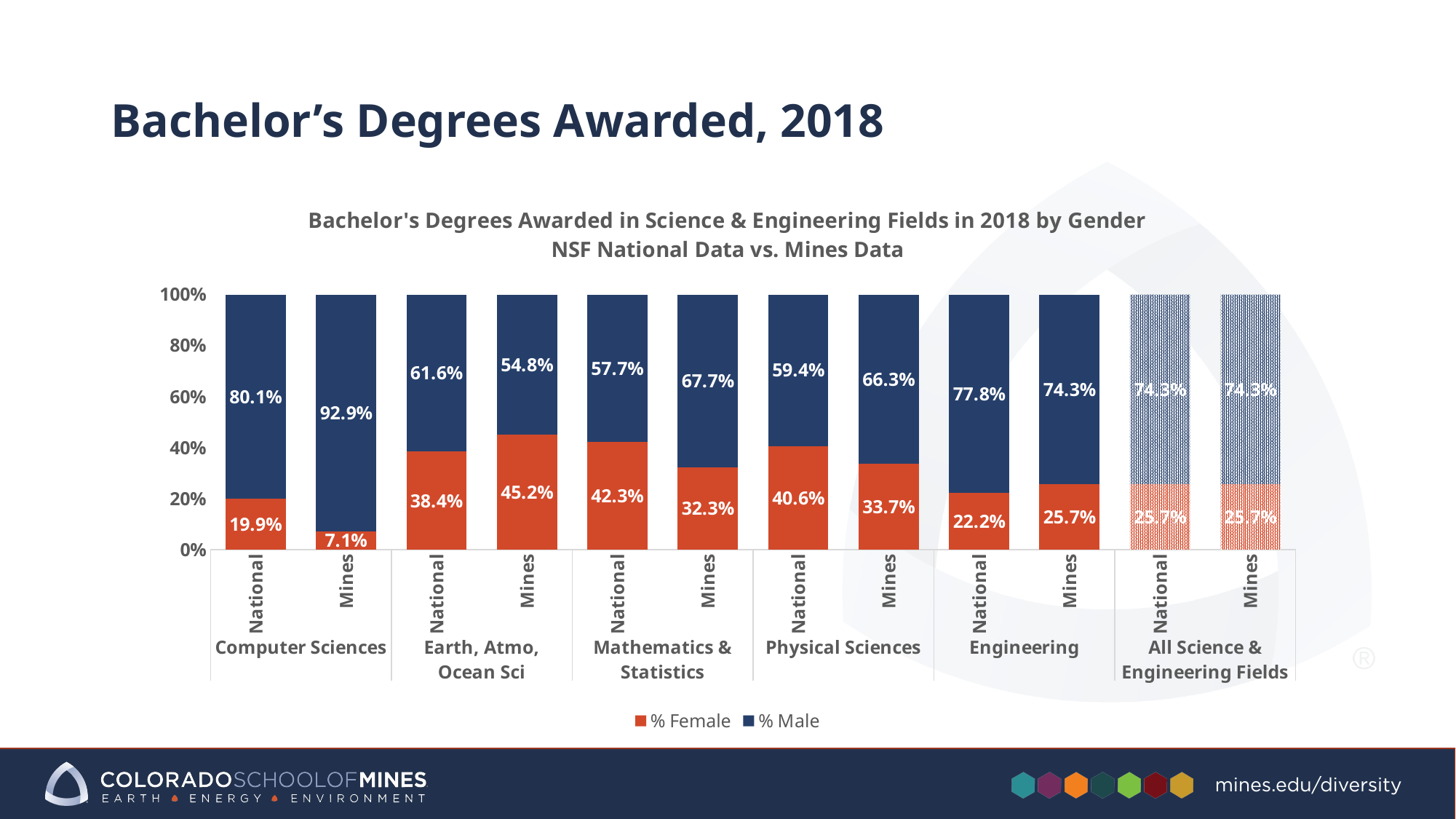
What is the % Male value for the National bar in Earth, Atmo, Ocean Sci? 61.6% What kind of chart is shown on the slide? Stacked bar chart How many series does the legend list? 2 Which bar has the highest % Female value? Mines, Earth, Atmo, Ocean Sci Which bar has the lowest % Female value? Mines, Computer Sciences How many bars are plotted in the chart? 12 What is the % Female value for the Mines bar in Computer Sciences? 7.1% What is the total of the stacked bar for National in Computer Sciences? 100% Which is larger: the % Female value for National or for Mines in Mathematics & Statistics? National What is the % Male value for the Mines bar in Physical Sciences? 66.3% What is the % Female value for the National bar in Mathematics & Statistics? 42.3% What is the difference between the % Female values for the National and Mines bars in Engineering? 3.5%